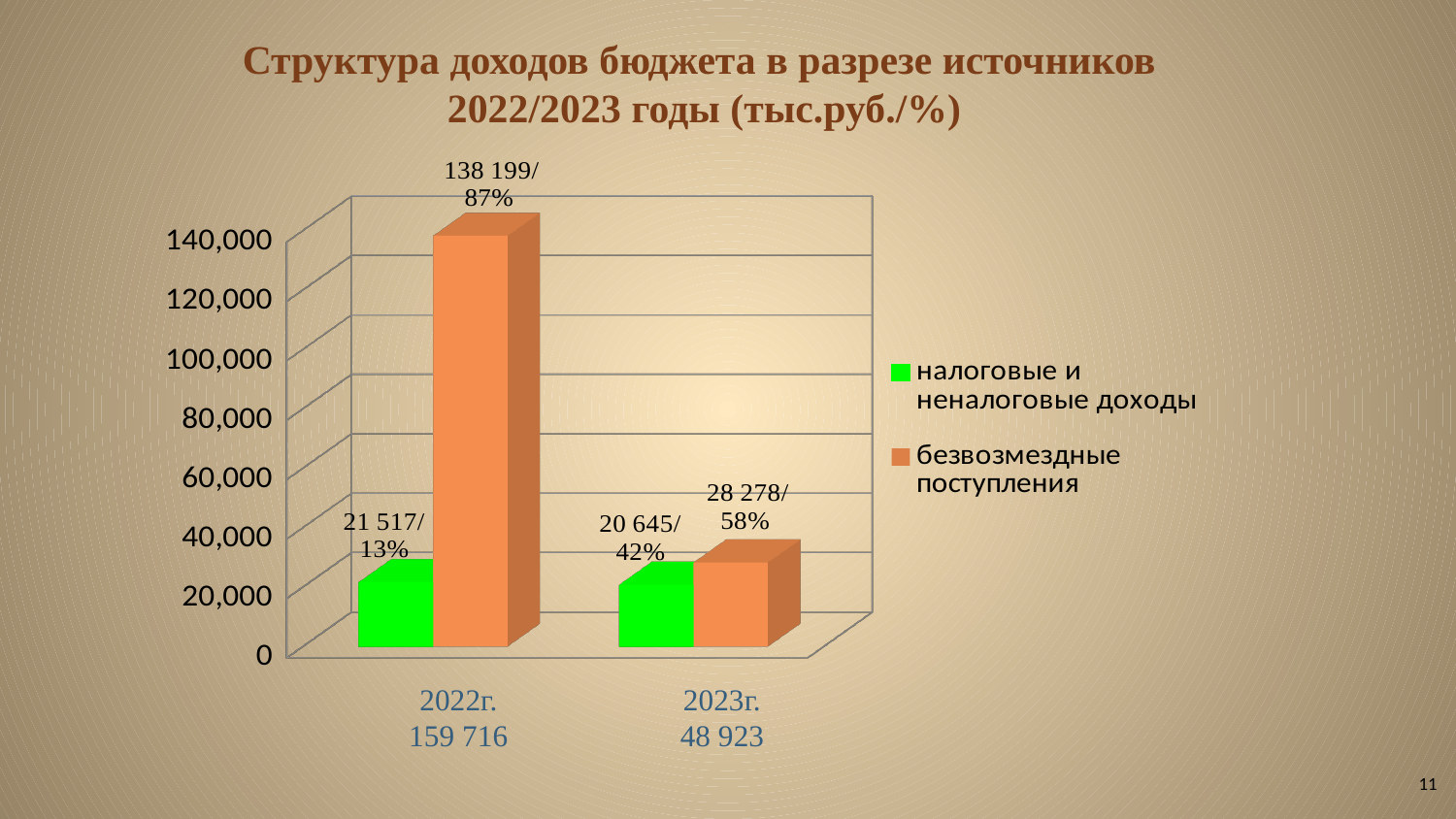
What kind of chart is shown on the slide? bar chart In 2023г., which is larger: налоговые и неналоговые доходы or безвозмездные поступления? безвозмездные поступления What is the value for налоговые и неналоговые доходы in 2022г.? 21 517/13% Is the value for безвозмездные поступления in 2022г. greater or less than 120,000? greater Which bar on the chart is the lowest? налоговые и неналоговые доходы in 2023г. What is the value for безвозмездные поступления in 2022г.? 138 199/87% What total is shown under the 2023г. category label? 48 923 How many series does the legend list? 2 What is the value for налоговые и неналоговые доходы in 2023г.? 20 645/42% What is the value for безвозмездные поступления in 2023г.? 28 278/58% What is the difference in thousand rubles between безвозмездные поступления in 2022г. and in 2023г.? 109 921 Which year has the higher value for безвозмездные поступления? 2022г.